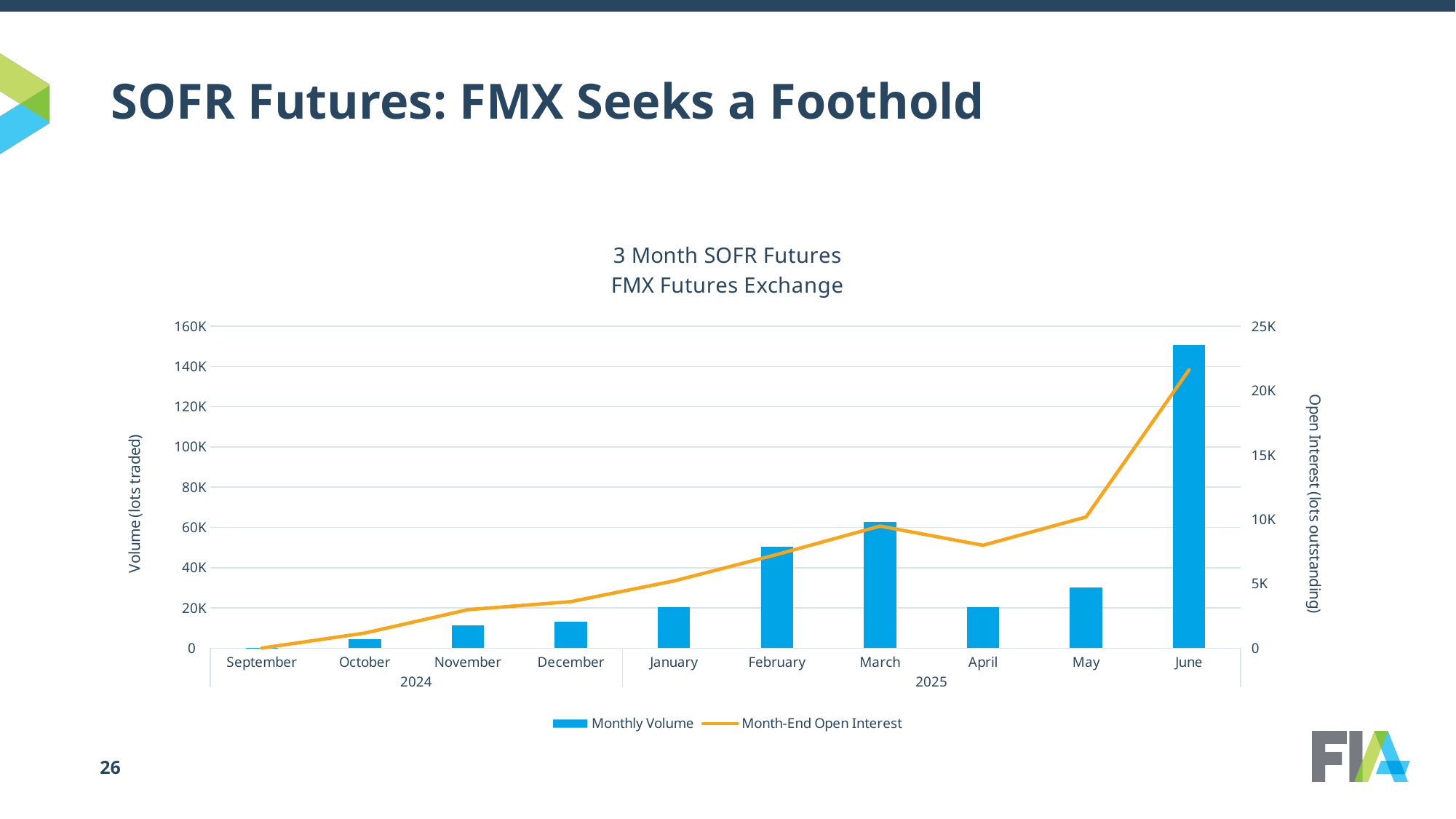
What kind of chart is shown on the slide? A combined bar and line chart Which month has the lowest Monthly Volume? September Does the Month-End Open Interest rise or fall from September to March? rise What is the title of the right-hand vertical axis? Open Interest (lots outstanding) Is the Monthly Volume for June greater or less than 140K? greater Which month has the highest Monthly Volume? June Which month has the larger Monthly Volume, February or May? February How many months are shown on the x axis? 10 Is the Monthly Volume for March greater or less than 80K? less How many series does the legend list? 2 Which month has the larger Monthly Volume, March or April? March Is the Month-End Open Interest for June greater or less than 20K? greater